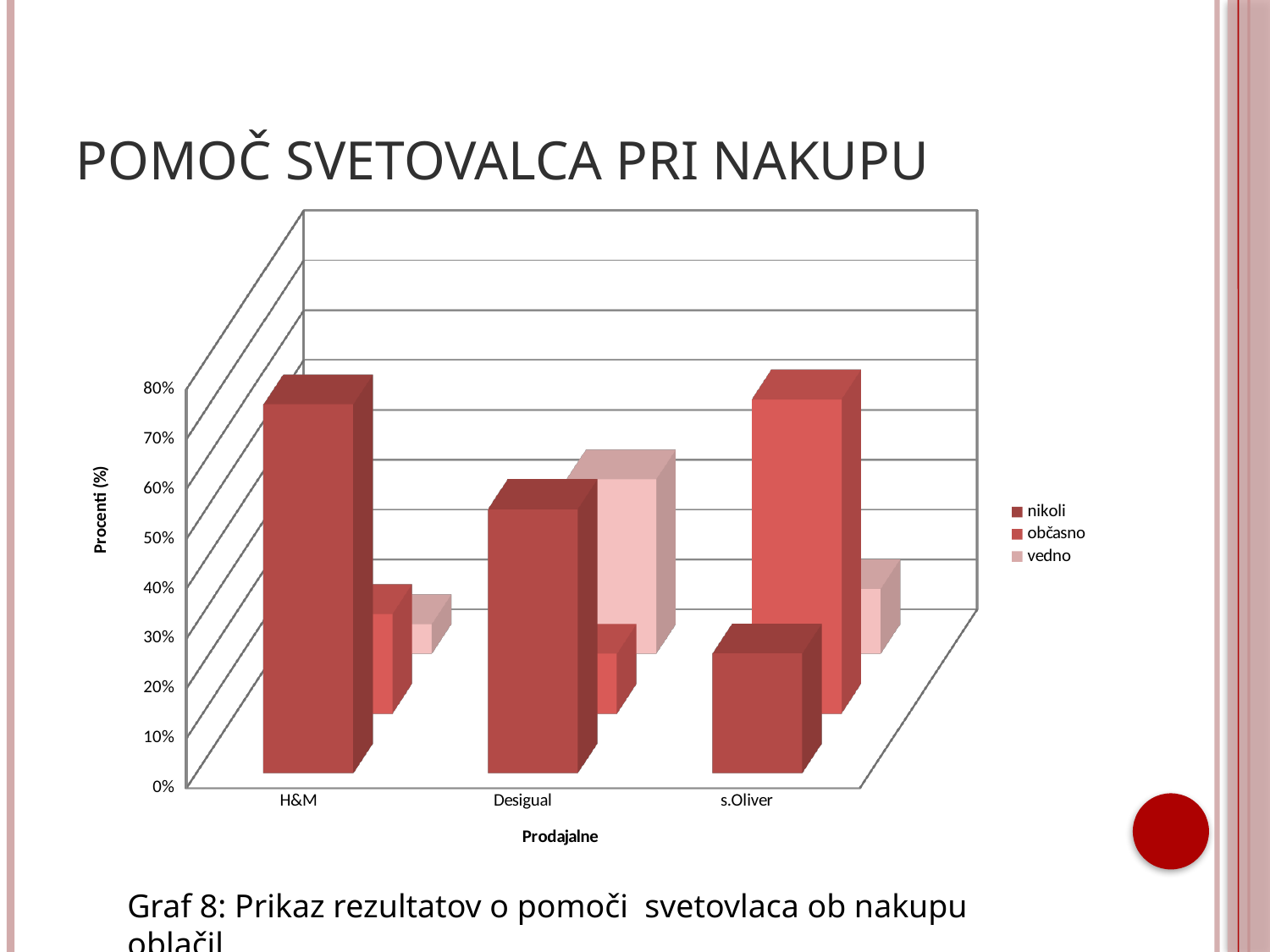
How many series does the legend list? 3 Which store has the lowest value for the 'nikoli' series? s.Oliver What is the label of the vertical axis? Procenti (%) For Desigual, which is larger: the 'vedno' bar or the 'občasno' bar? vedno Is the 'nikoli' value for H&M greater or less than 50%? greater For s.Oliver, which series has the highest bar? občasno Is the 'nikoli' value for s.Oliver greater or less than 40%? less How many stores (categories) are shown on the x axis? 3 Is the 'občasno' value for s.Oliver greater or less than 50%? greater What kind of chart is shown on the slide? bar chart Which store has the highest value for the 'nikoli' series? H&M Which is larger: the 'nikoli' value for H&M or the 'nikoli' value for Desigual? H&M